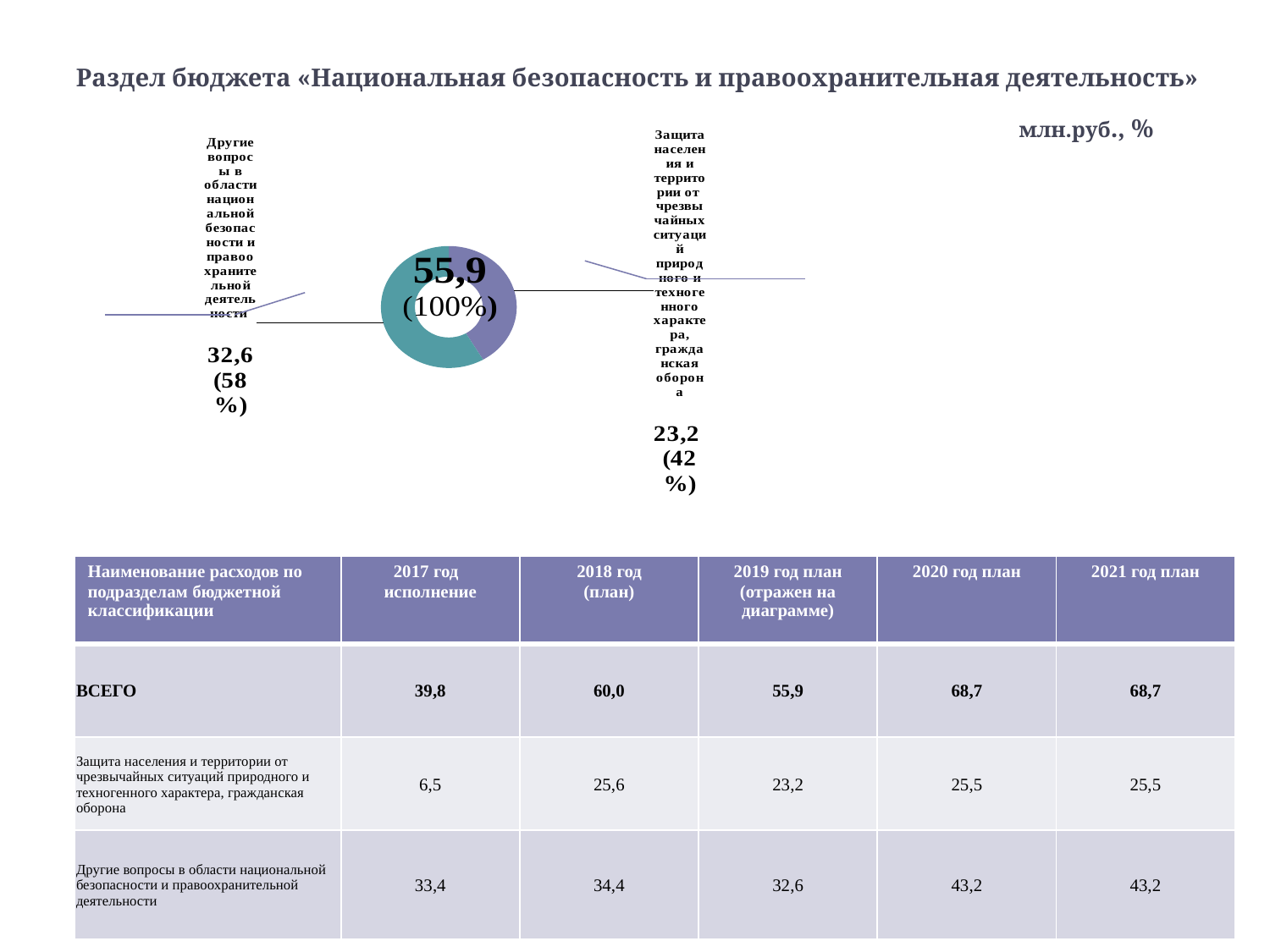
Which slice of the doughnut chart is the largest? Другие вопросы в области национальной безопасности и правоохранительной деятельности What share of the doughnut does the slice "Защита населения и территории от чрезвычайных ситуаций природного и техногенного характера, гражданская оборона" represent? 42% What value is shown for the slice "Другие вопросы в области национальной безопасности и правоохранительной деятельности"? 32,6 What share of the doughnut does the slice "Другие вопросы в области национальной безопасности и правоохранительной деятельности" represent? 58% What total value is printed in the centre of the doughnut chart? 55,9 (100%) What is the difference between the two slice values in the doughnut chart (32,6 and 23,2)? 9,4 How many slices does the doughnut chart have? 2 What value is shown for the slice "Защита населения и территории от чрезвычайных ситуаций природного и техногенного характера, гражданская оборона"? 23,2 Which is larger: the value for "Другие вопросы..." or the value for "Защита населения..."? Другие вопросы в области национальной безопасности и правоохранительной деятельности Which slice of the doughnut chart is the smallest? Защита населения и территории от чрезвычайных ситуаций природного и техногенного характера, гражданская оборона What units are indicated for the chart on the slide? млн.руб., % What kind of chart is shown on the slide? doughnut (pie) chart